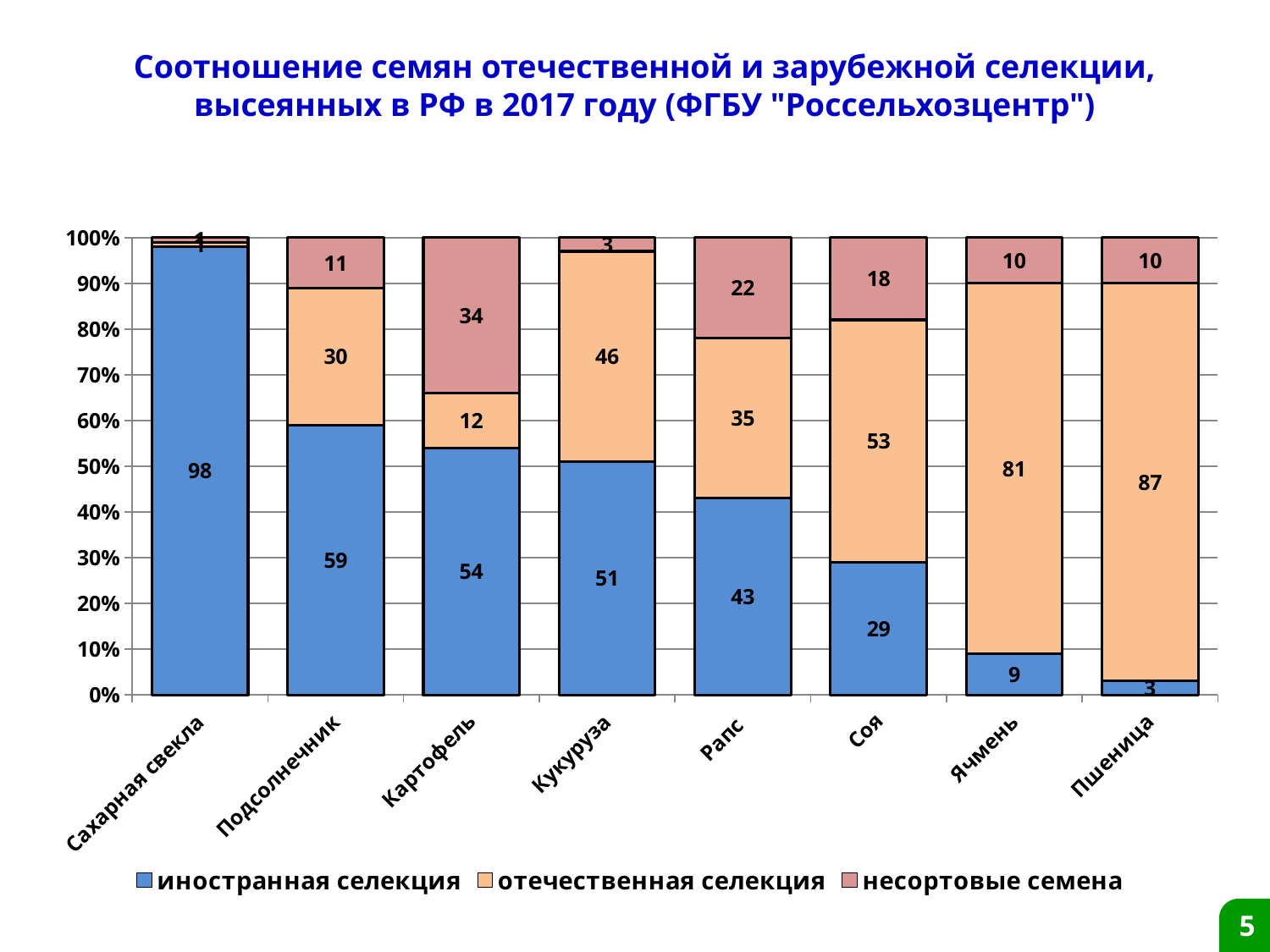
Which is larger: the несортовые семена value for Рапс or for Соя? Рапс What is the value of несортовые семена for Картофель? 34 What is the value of иностранная селекция for Подсолнечник? 59 What is the value of отечественная селекция for Пшеница? 87 How many crop categories are shown on the x axis? 8 Which crop has the highest value for иностранная селекция? Сахарная свекла What is the difference between the отечественная селекция values for Ячмень and Соя? 28 Which crop has the lowest value for иностранная селекция? Пшеница What type of chart is shown on the slide? stacked bar chart Which series is shown in blue in the legend? иностранная селекция What is the value of отечественная селекция for Кукуруза? 46 How many series does the legend list? 3